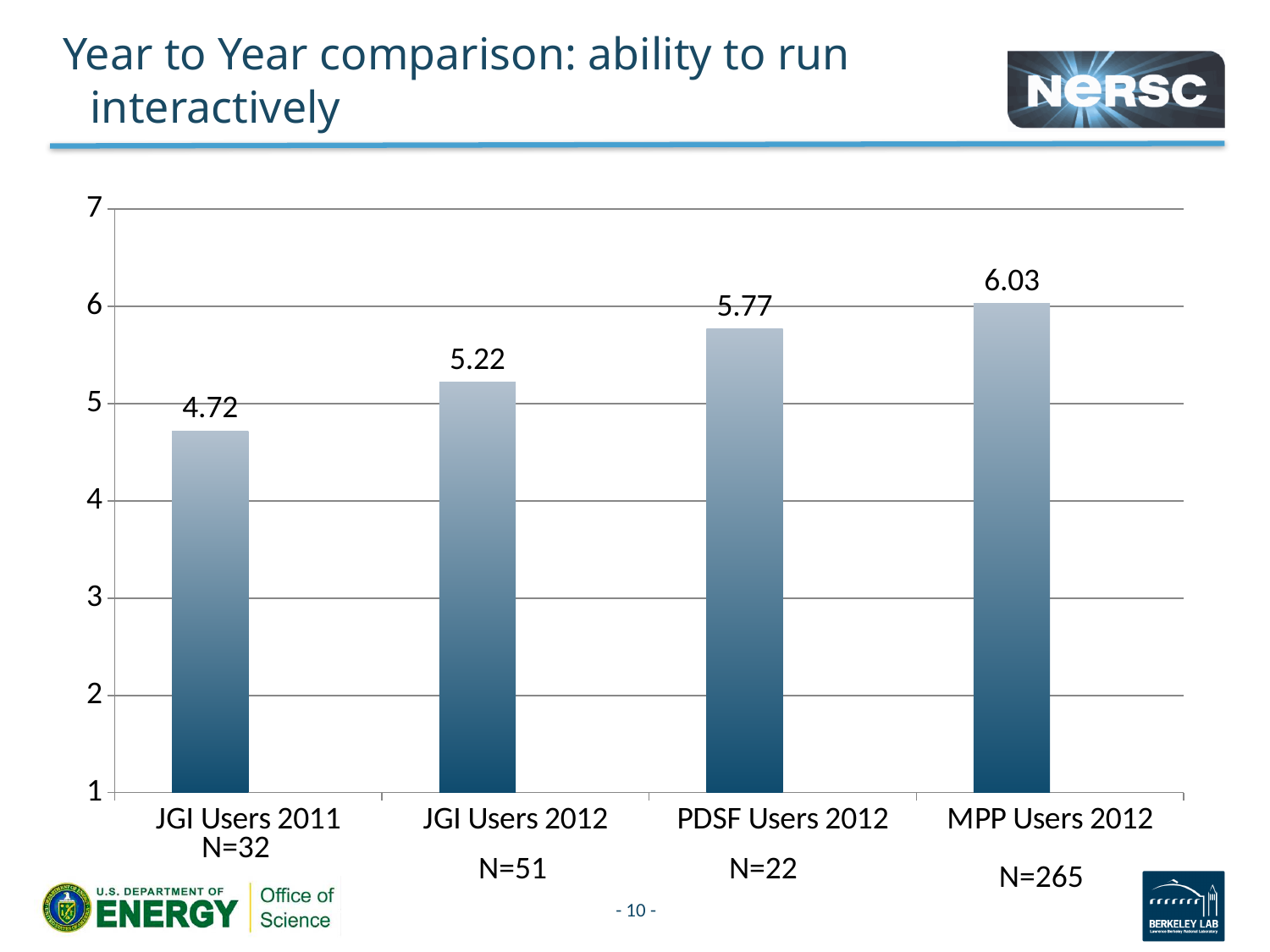
Do the values rise or fall from left to right across the categories? Rise What is the value for PDSF Users 2012? 5.77 What is the difference between the values for MPP Users 2012 and PDSF Users 2012? 0.26 What is the value for JGI Users 2011? 4.72 What is the value for MPP Users 2012? 6.03 Which category has the highest value? MPP Users 2012 What is the value for JGI Users 2012? 5.22 Which category has the lowest value? JGI Users 2011 What kind of chart is shown on the slide? Bar chart How many categories are shown on the chart? 4 Which is larger, the value for PDSF Users 2012 or JGI Users 2012? PDSF Users 2012 What is the difference between the values for JGI Users 2012 and JGI Users 2011? 0.50